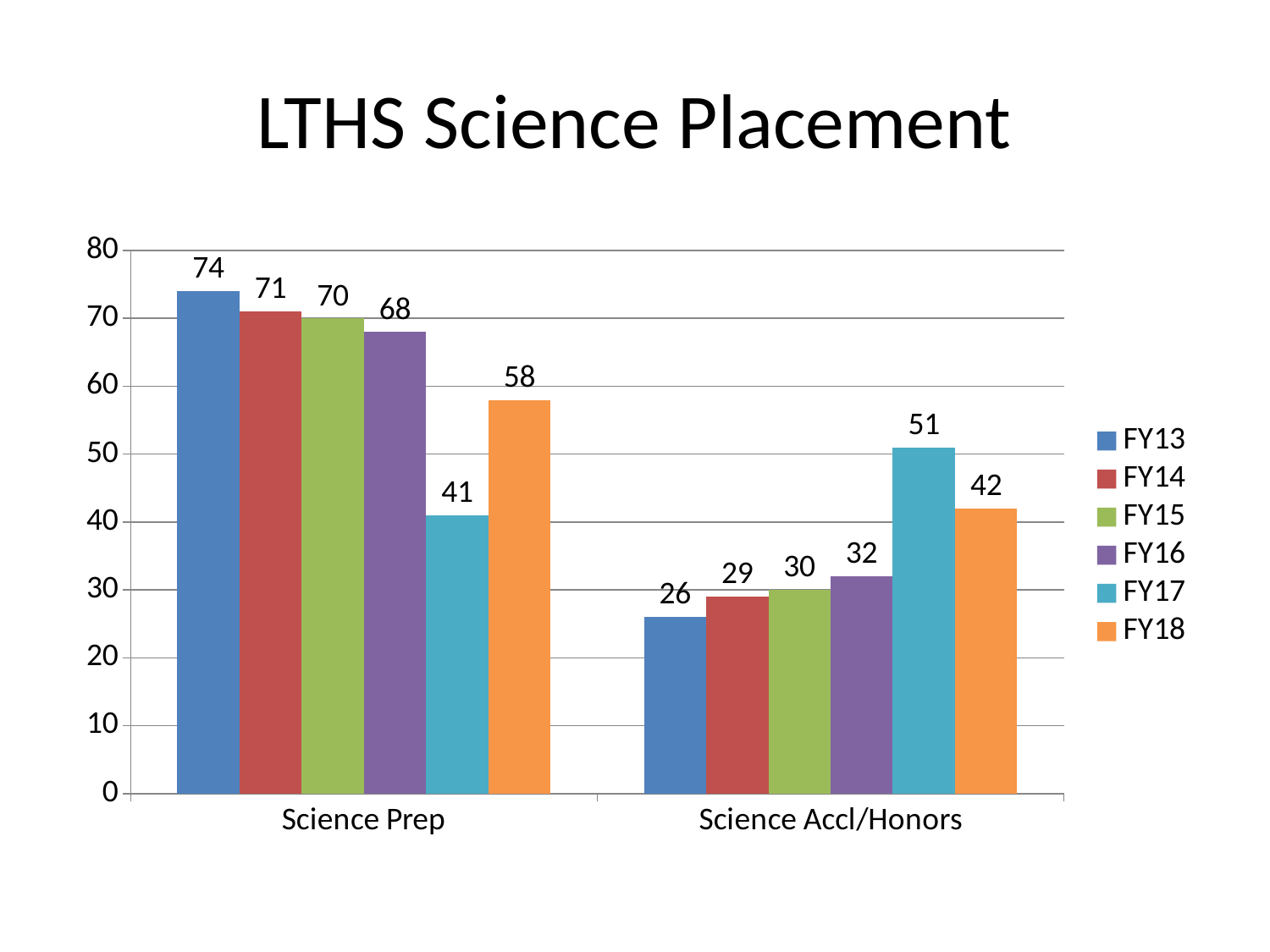
What is the value for FY17 in the Science Accl/Honors category? 51 What is the title of the chart? LTHS Science Placement How many categories are shown on the x axis? 2 What is the value for FY18 in the Science Prep category? 58 Which series has the highest value in the Science Prep category? FY13 What kind of chart is shown on the slide? Bar chart Which is larger: the FY16 value for Science Prep or the FY16 value for Science Accl/Honors? Science Prep Which series has the lowest value in the Science Accl/Honors category? FY13 What is the value for FY13 in the Science Prep category? 74 What is the difference between the FY13 and FY18 values in the Science Prep category? 16 What is the difference between the FY17 values for Science Prep and Science Accl/Honors? 10 How many series does the legend list? 6